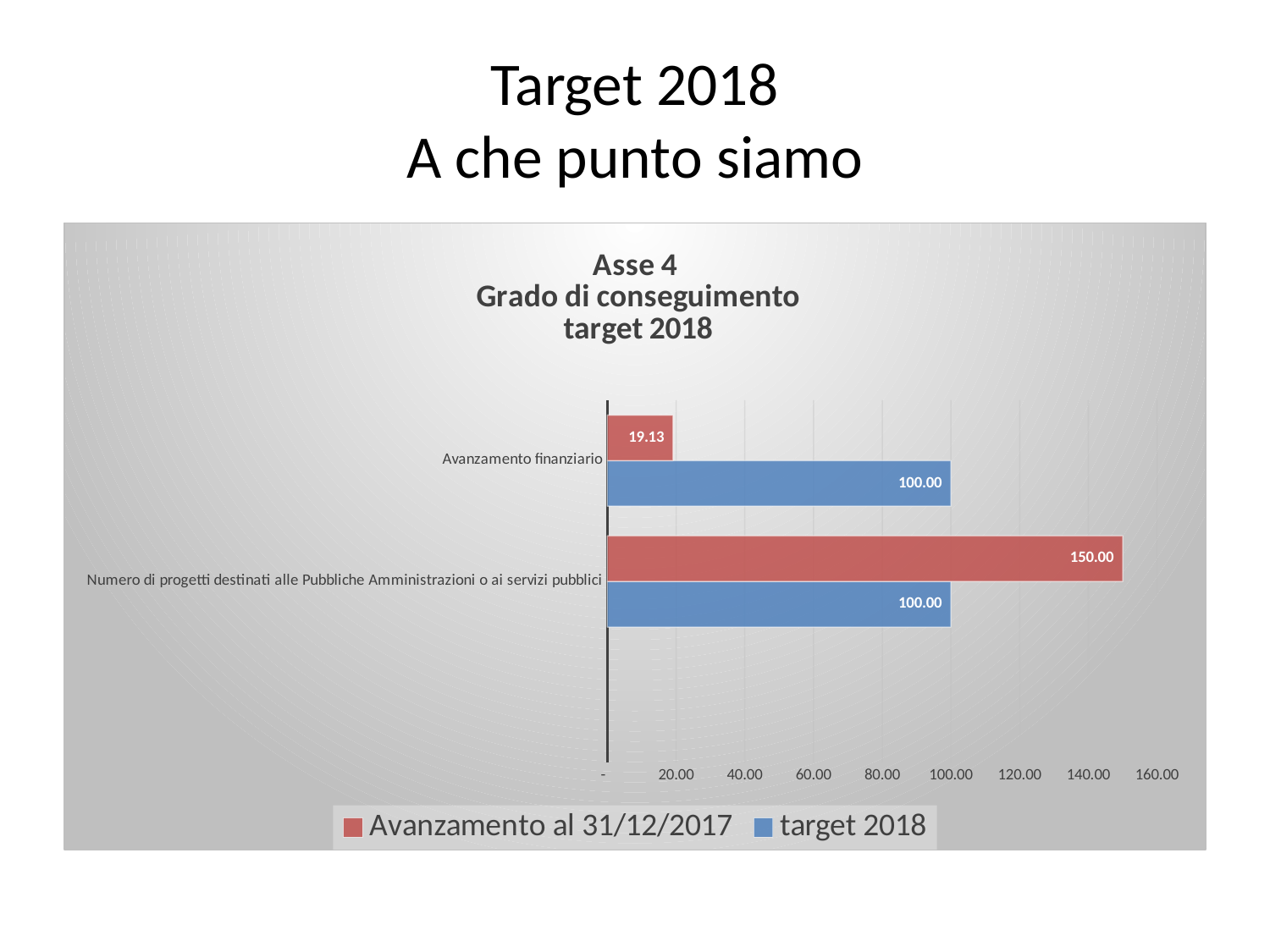
Which category has the highest Avanzamento al 31/12/2017 value? Numero di progetti destinati alle Pubbliche Amministrazioni o ai servizi pubblici What is the target 2018 value for Avanzamento finanziario? 100.00 What is the value of Avanzamento al 31/12/2017 for Numero di progetti destinati alle Pubbliche Amministrazioni o ai servizi pubblici? 150.00 What is the difference between the Avanzamento al 31/12/2017 value and the target 2018 value for Numero di progetti destinati alle Pubbliche Amministrazioni o ai servizi pubblici? 50.00 What is the difference between the target 2018 value and the Avanzamento al 31/12/2017 value for Avanzamento finanziario? 80.87 What is the target 2018 value for Numero di progetti destinati alle Pubbliche Amministrazioni o ai servizi pubblici? 100.00 Which category has the lowest Avanzamento al 31/12/2017 value? Avanzamento finanziario How many series does the legend list? 2 How many categories are shown on the chart? 2 What is the value of Avanzamento al 31/12/2017 for Avanzamento finanziario? 19.13 For Avanzamento finanziario, which is larger: Avanzamento al 31/12/2017 or target 2018? target 2018 What kind of chart is shown on the slide? bar chart